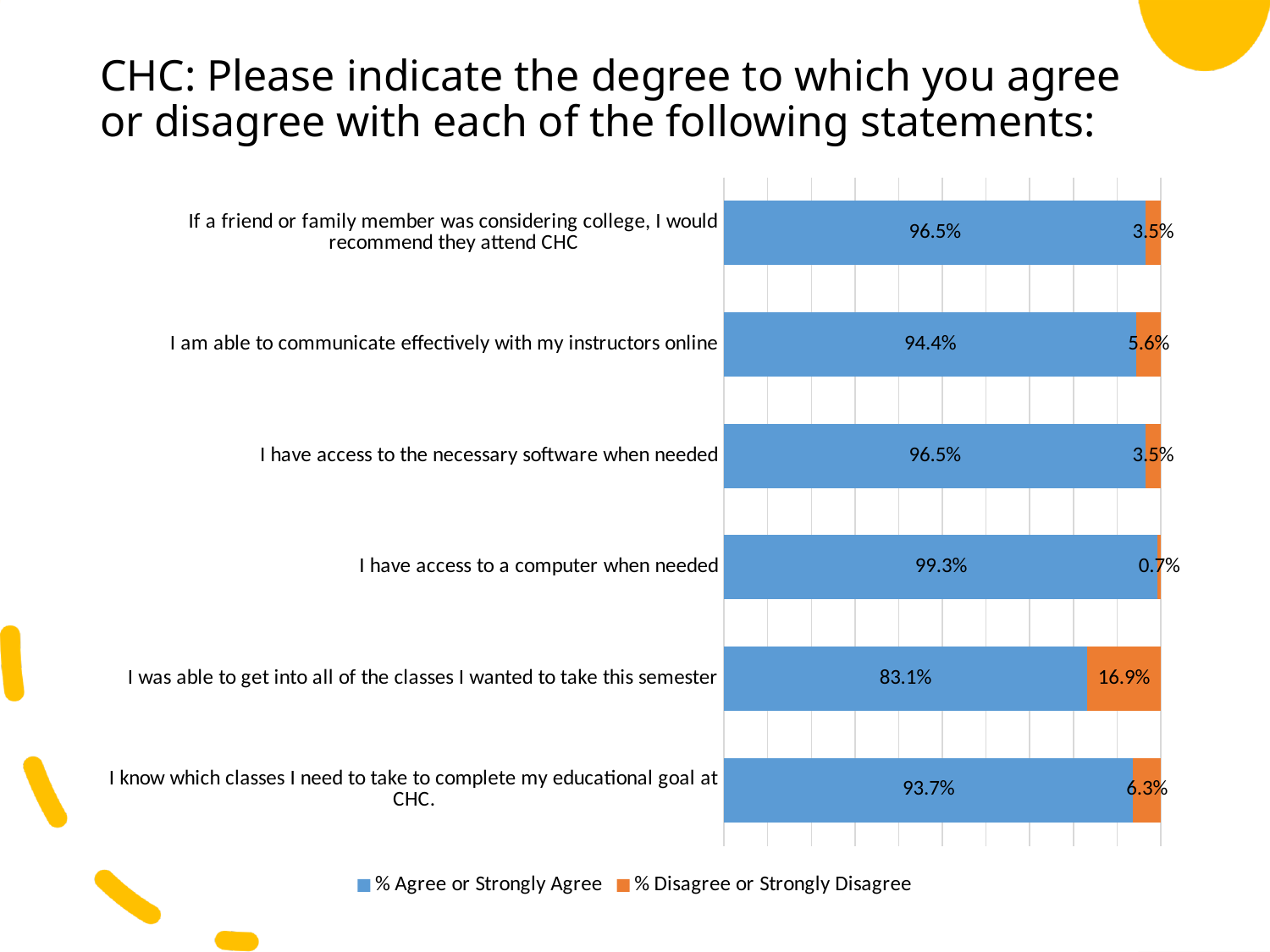
How many series does the legend list? 2 What is the % Agree or Strongly Agree value for 'I am able to communicate effectively with my instructors online'? 94.4% What percentage agree or strongly agree that they have access to a computer when needed? 99.3% What is the difference between the % Agree or Strongly Agree for 'I have access to a computer when needed' and for 'I was able to get into all of the classes I wanted to take this semester'? 16.2% What percentage disagree or strongly disagree with 'I was able to get into all of the classes I wanted to take this semester'? 16.9% What kind of chart is shown on the slide? Bar chart What is the % Disagree or Strongly Disagree value for 'I know which classes I need to take to complete my educational goal at CHC.'? 6.3% Which has a larger % Disagree or Strongly Disagree: 'I am able to communicate effectively with my instructors online' or 'I have access to the necessary software when needed'? I am able to communicate effectively with my instructors online Which statement has the lowest % Agree or Strongly Agree? I was able to get into all of the classes I wanted to take this semester Which statement has the highest % Agree or Strongly Agree? I have access to a computer when needed How many statements are shown in the chart? 6 What is the total of the stacked bar for 'I have access to the necessary software when needed'? 100%